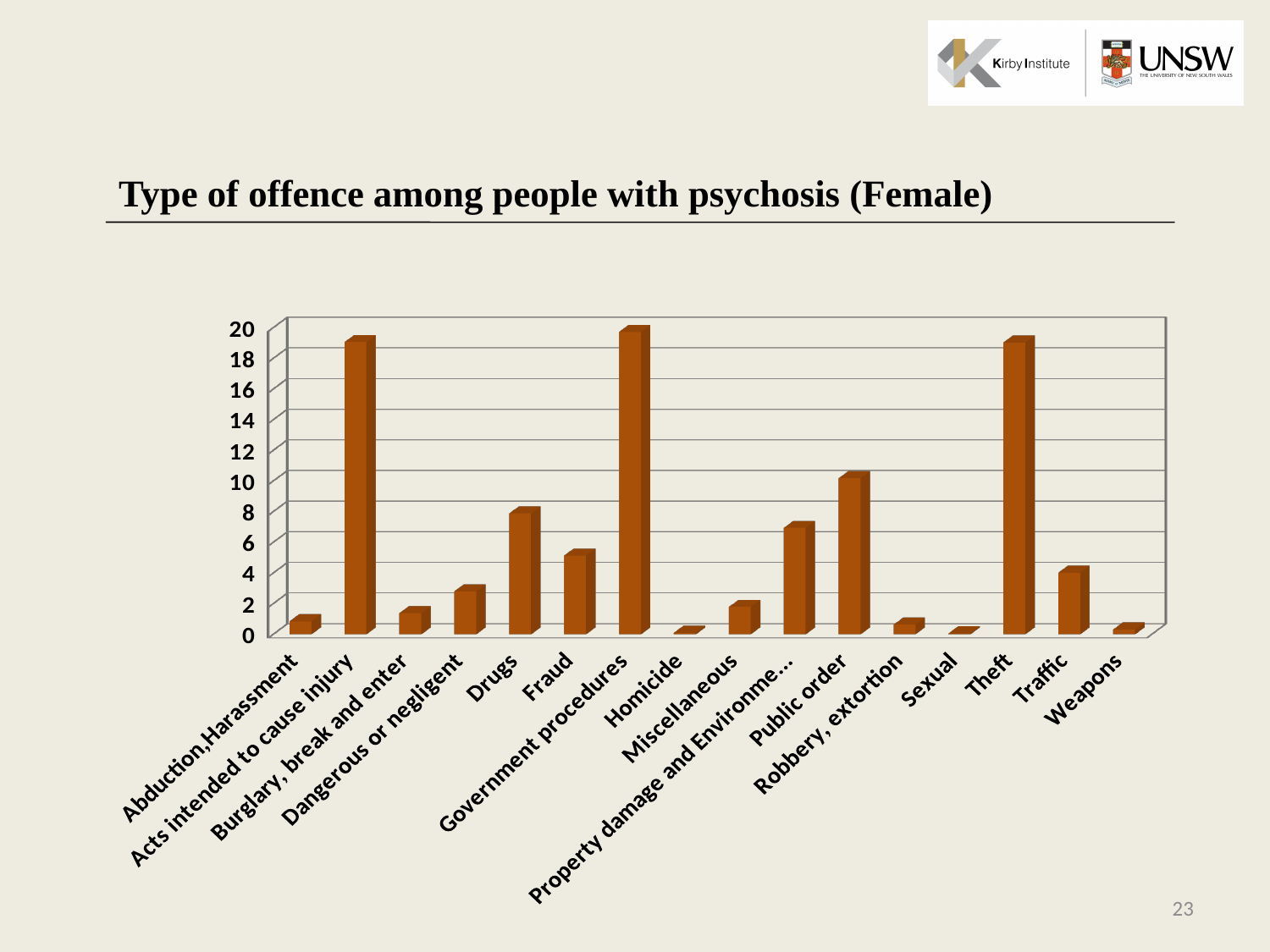
How many offence categories are shown on the x axis? 16 Is the value for Fraud greater or less than 6? less Which is larger, the value for Drugs or the value for Fraud? Drugs What is the title of the chart? Type of offence among people with psychosis (Female) Is the value for Traffic greater or less than 6? less Which is larger, the value for Public order or the value for Drugs? Public order Is the value for Drugs greater or less than 6? greater Which is larger, the value for Theft or the value for Traffic? Theft What type of chart is shown on the slide? bar chart